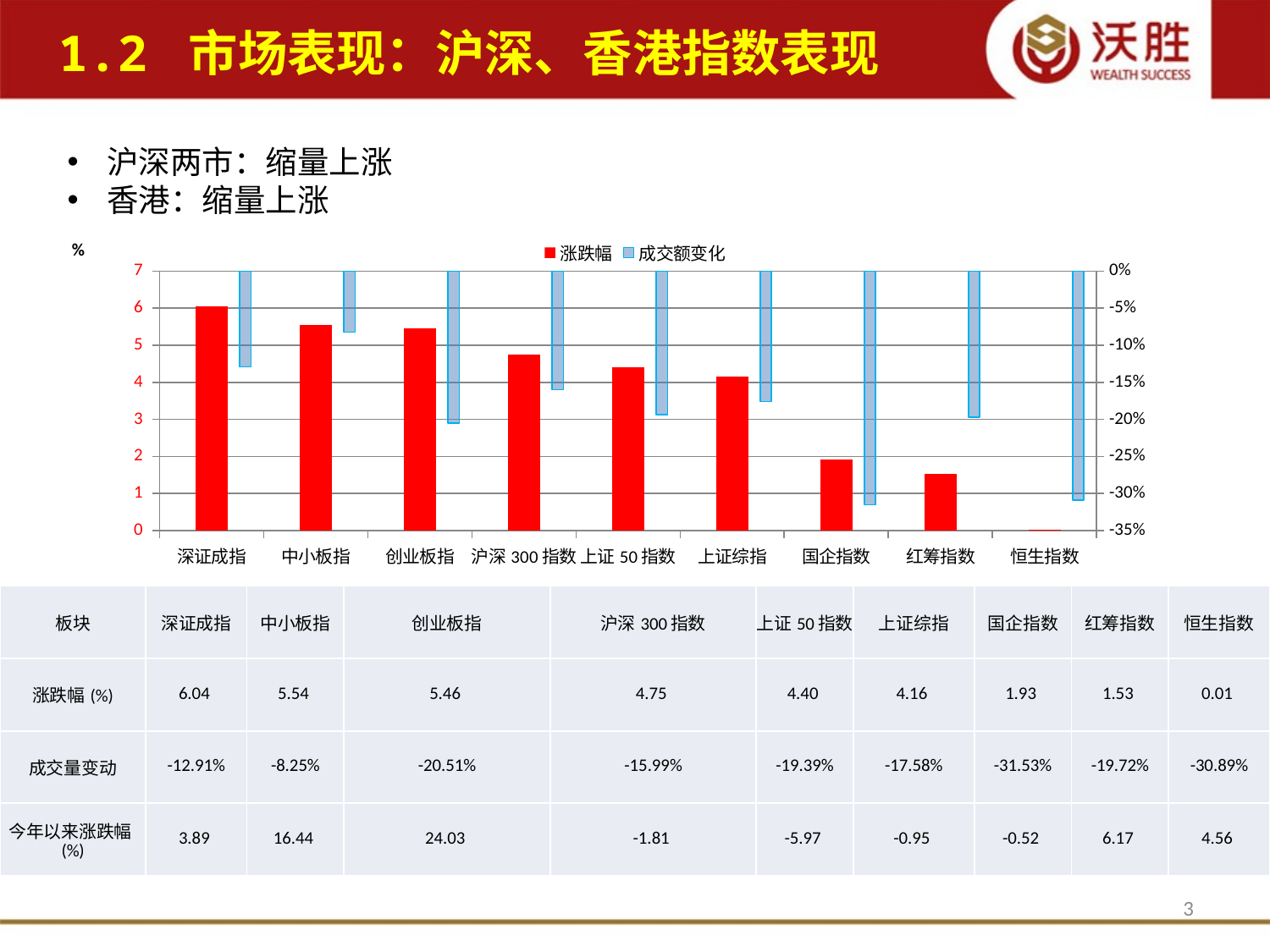
How many index categories are plotted along the x axis of the chart? 9 Is the 成交额变化 value for 中小板指 greater or less than -10%? greater Which has the larger 涨跌幅 value, 创业板指 or 沪深 300 指数? 创业板指 What are the two entries in the chart legend? 涨跌幅 and 成交额变化 What is the difference between the 涨跌幅 (%) values of 深证成指 and 中小板指? 0.50 Is the 涨跌幅 value for 深证成指 greater or less than 5? greater How many series does the chart legend list? 2 What is the 涨跌幅 (%) value for 上证综指 shown on the slide? 4.16 What kind of chart is shown on the slide? bar chart Which index has the lowest 涨跌幅 value in the chart? 恒生指数 Which index has the highest 涨跌幅 value in the chart? 深证成指 Do the 涨跌幅 values rise or fall moving from left to right along the x axis? fall